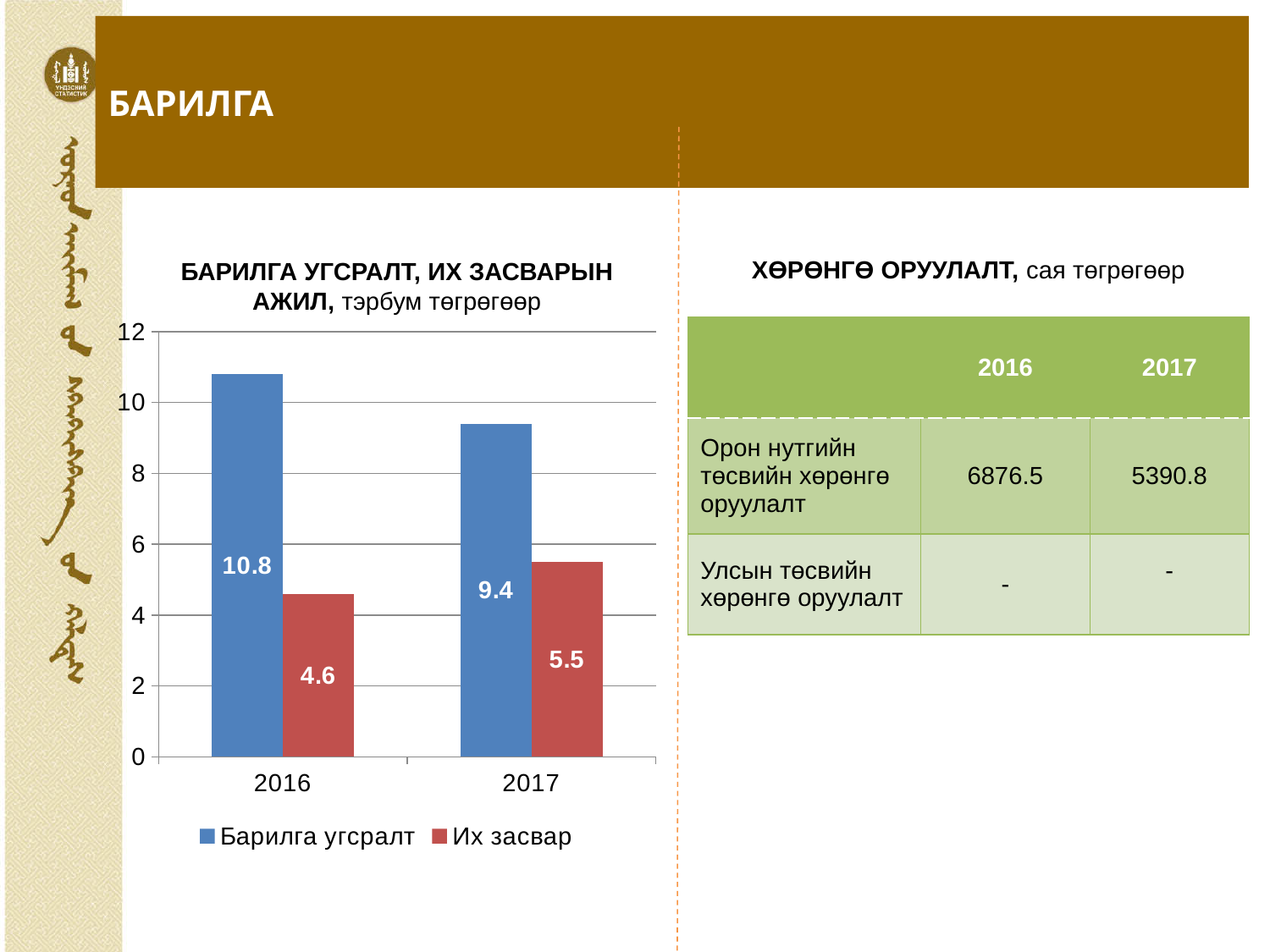
How many series does the chart legend list? 2 Which is larger in 2017: Барилга угсралт or Их засвар? Барилга угсралт Which year has the lowest value for Их засвар? 2016 What is the value for Их засвар in 2016? 4.6 How many years are shown on the x axis of the chart? 2 What is the value for Их засвар in 2017? 5.5 What kind of chart is shown on the slide? bar chart Which year has the highest value for Барилга угсралт? 2016 What is the value for Барилга угсралт in 2016? 10.8 What is the value for Барилга угсралт in 2017? 9.4 Does the value for Барилга угсралт rise or fall from 2016 to 2017? fall What is the difference between Барилга угсралт and Их засвар in 2016? 6.2